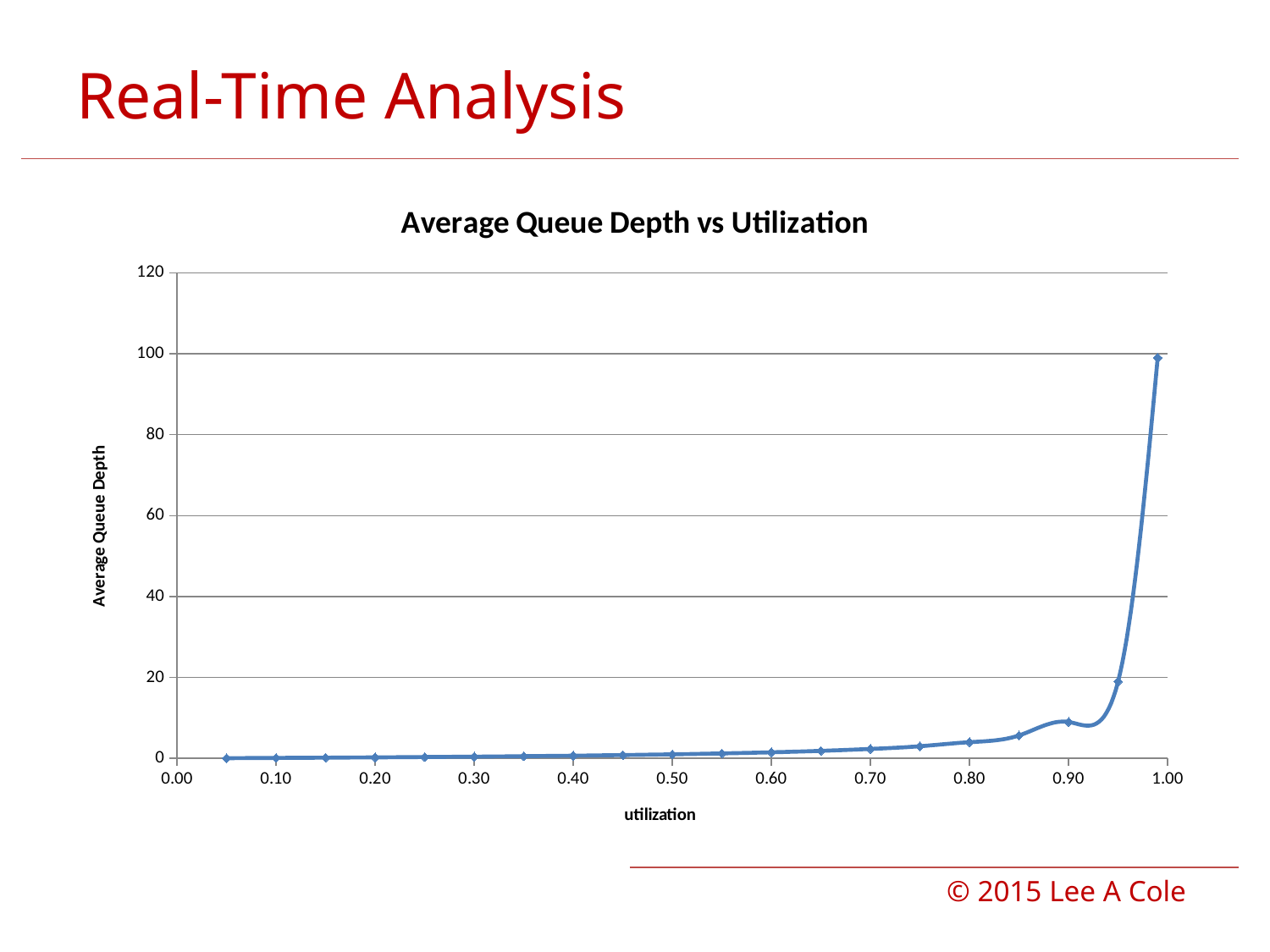
Which has a larger average queue depth: utilization 0.70 or utilization 0.95? 0.95 Does the average queue depth generally rise or fall as utilization increases? rise What is the label of the vertical axis? Average Queue Depth Is the average queue depth at utilization 0.90 greater or less than 20? less Is the average queue depth at utilization 0.95 greater or less than 10? greater Is the average queue depth at utilization 0.99 greater or less than 80? greater How many data points are plotted on the line? 20 What type of chart is shown on the slide? line chart Which has a larger average queue depth: utilization 0.95 or utilization 0.99? 0.99 What is the title of the chart? Average Queue Depth vs Utilization